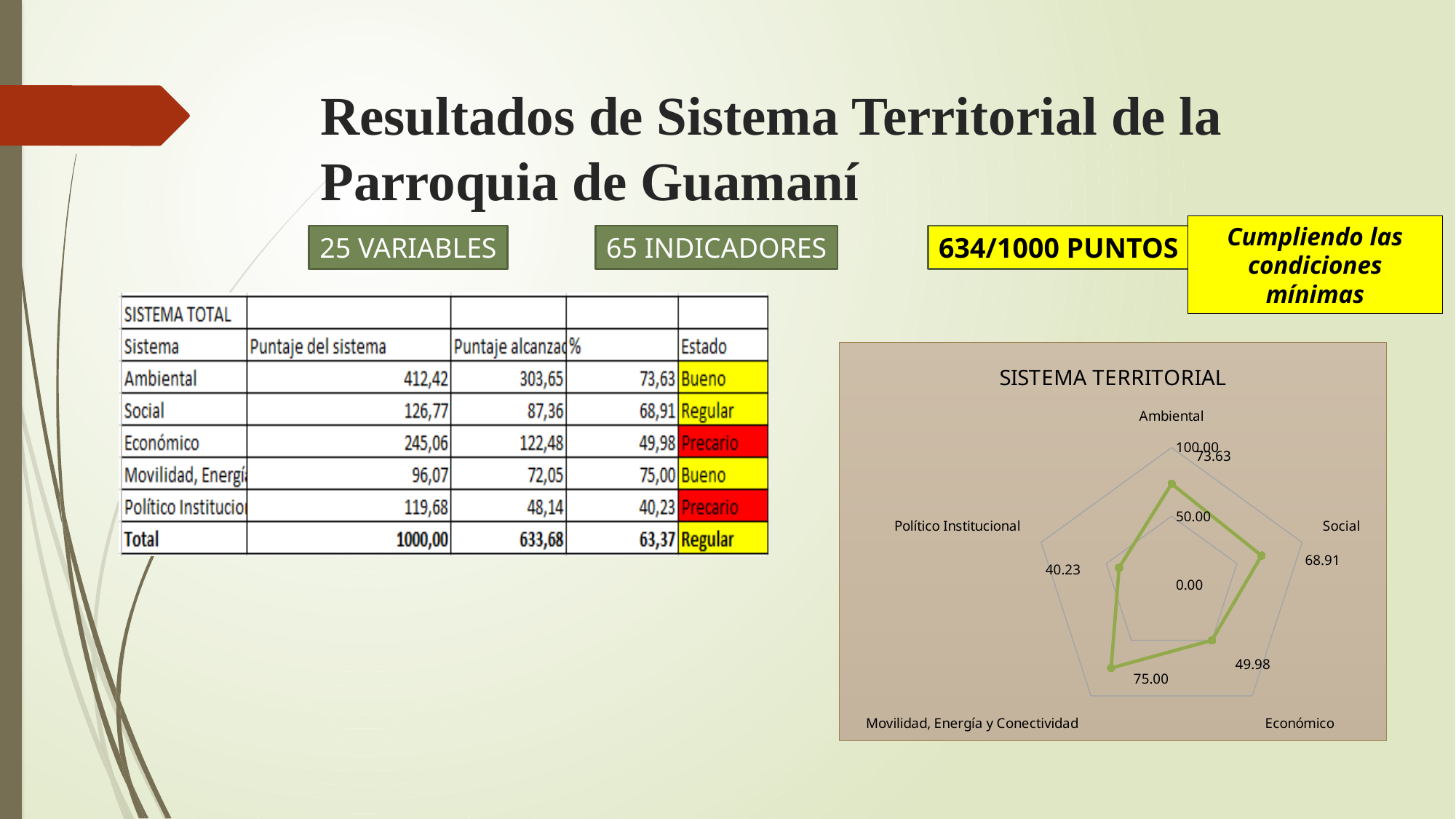
What is the value for Económico in the SISTEMA TERRITORIAL chart? 49.98 What is the value for Político Institucional in the SISTEMA TERRITORIAL chart? 40.23 In the SISTEMA TERRITORIAL chart, is the value for Económico greater or less than 50.00? less What is the value for Ambiental in the SISTEMA TERRITORIAL chart? 73.63 What is the value for Social in the SISTEMA TERRITORIAL chart? 68.91 How many categories are plotted in the SISTEMA TERRITORIAL chart? 5 What is the value for Movilidad, Energía y Conectividad in the SISTEMA TERRITORIAL chart? 75.00 In the SISTEMA TERRITORIAL chart, what is the difference between the values for Ambiental and Político Institucional? 33.40 Which category has the lowest value in the SISTEMA TERRITORIAL chart? Político Institucional What kind of chart is the SISTEMA TERRITORIAL chart? Radar chart Which category has the highest value in the SISTEMA TERRITORIAL chart? Movilidad, Energía y Conectividad In the SISTEMA TERRITORIAL chart, which is larger: the value for Social or the value for Económico? Social